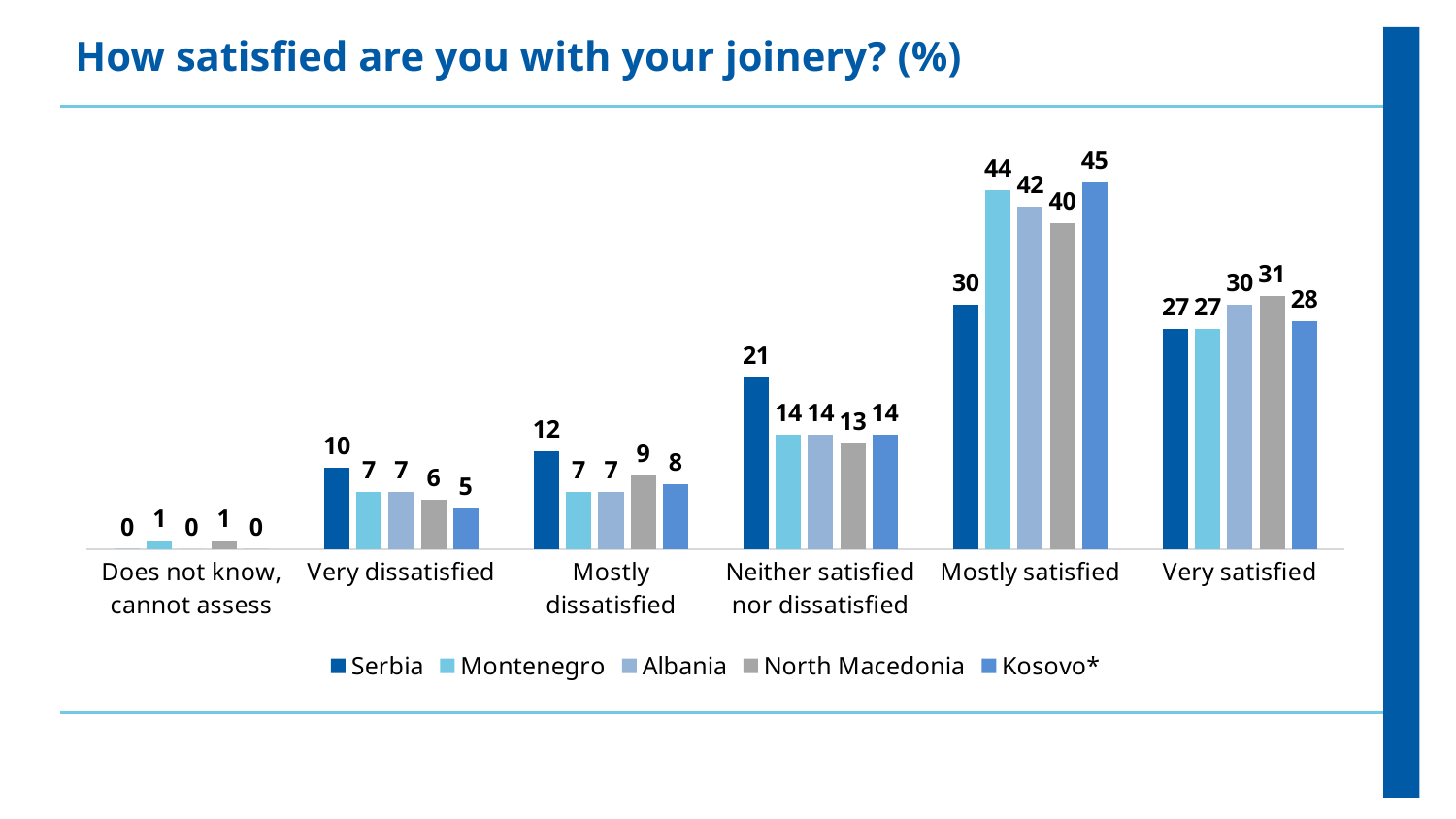
How many response categories are shown on the x axis? 6 How many series does the legend list? 5 What is the difference between Montenegro and Serbia in the Mostly satisfied category? 14 What is the value for Kosovo* in the Mostly satisfied category? 45 What kind of chart is shown on the slide? Bar chart What is the value for North Macedonia in the Very satisfied category? 31 Which country has the lowest value in the Very dissatisfied category? Kosovo* Which country has the highest value in the Mostly satisfied category? Kosovo* What is the title of the chart? How satisfied are you with your joinery? (%) What is the value for Serbia in the Neither satisfied nor dissatisfied category? 21 What is the difference between Serbia and Albania in the Mostly dissatisfied category? 5 Which is larger in the Very satisfied category, Albania or Kosovo*? Albania